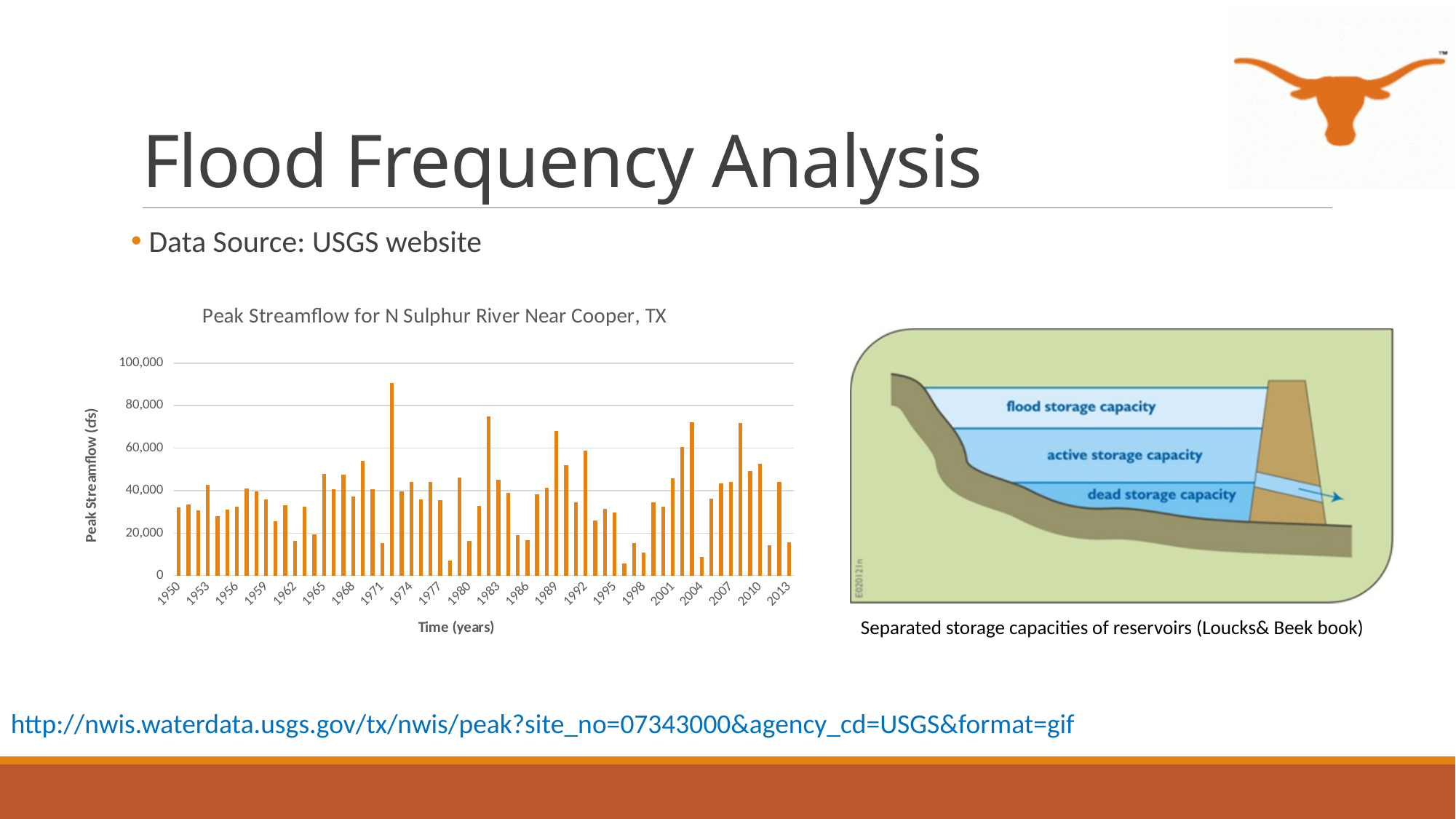
What is the label of the vertical axis of the chart? Peak Streamflow (cfs) Is the peak streamflow value for 2013 greater or less than 20,000? less What is the last year shown on the horizontal axis of the chart? 2013 Which year has the larger peak streamflow, 1950 or 2013? 1950 Does any bar in the chart exceed 100,000? No What type of chart is shown on the slide? Bar chart Is the tallest bar in the chart greater or less than 80,000? greater What is the title of the chart? Peak Streamflow for N Sulphur River Near Cooper, TX What is the highest value shown on the vertical axis of the chart? 100,000 What is the first year shown on the horizontal axis of the chart? 1950 How many year labels are printed along the horizontal axis of the chart? 22